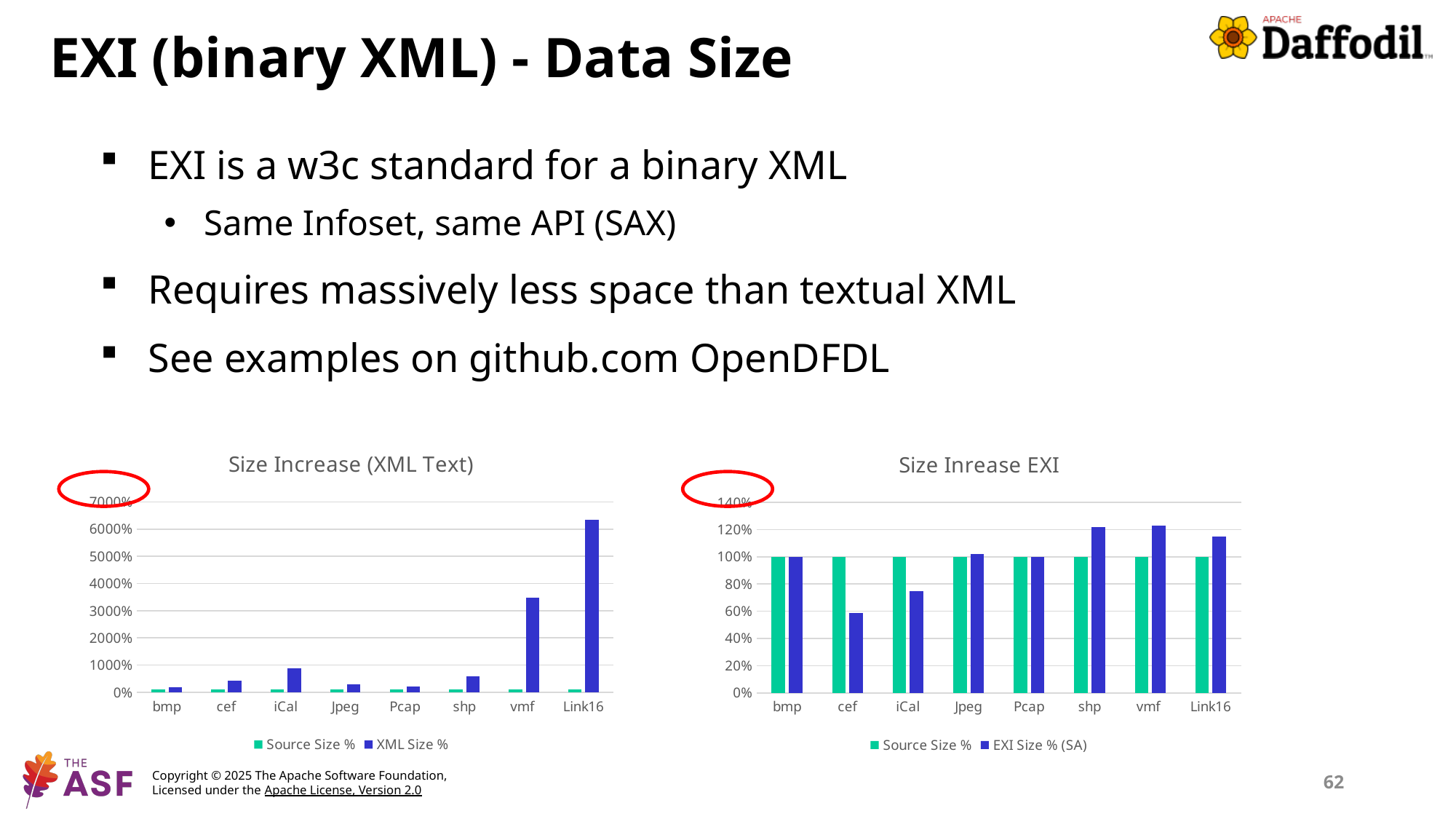
In the 'Size Inrease EXI' chart, is the EXI Size % (SA) for shp greater or less than 100%? greater In the 'Size Inrease EXI' chart, which category has the lowest EXI Size % (SA)? cef In the 'Size Inrease EXI' chart, what is the Source Size % for Jpeg? 100% What kind of chart is the 'Size Increase (XML Text)' chart? bar chart In the 'Size Increase (XML Text)' chart, which category has the highest XML Size %? Link16 In the 'Size Increase (XML Text)' chart, is the XML Size % for vmf greater or less than 3000%? greater What is the title of the chart on the right side of the slide? Size Inrease EXI In the 'Size Increase (XML Text)' chart, is the XML Size % for Link16 greater or less than 6000%? greater How many categories are shown on the x axis of the 'Size Increase (XML Text)' chart? 8 In the 'Size Increase (XML Text)' chart, which has the larger XML Size %, vmf or Link16? Link16 How many series does the legend of the 'Size Inrease EXI' chart list? 2